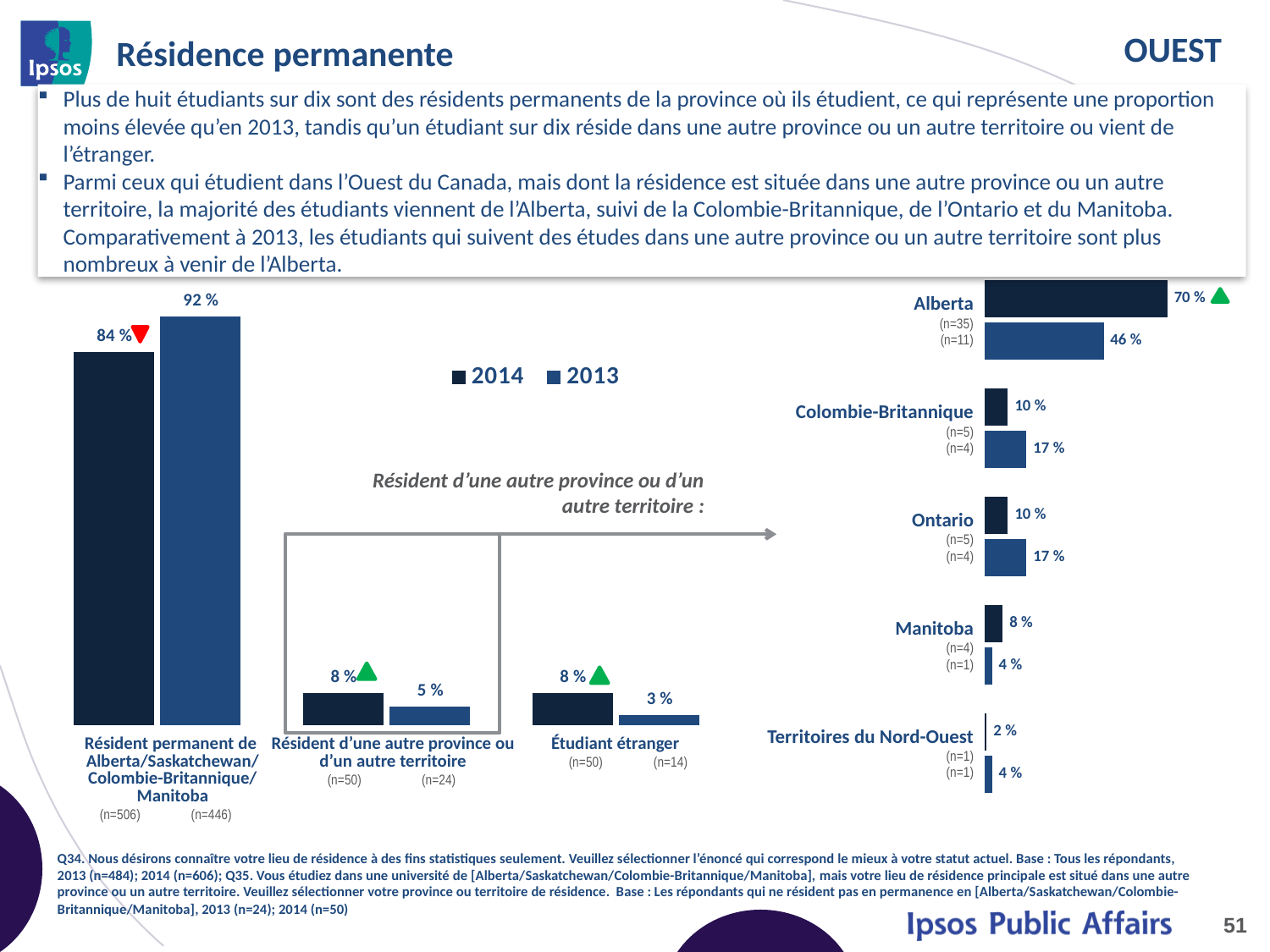
In the left chart, what is the 2013 value for 'Étudiant étranger'? 3 % In the left chart, which is larger for 'Résident d'une autre province ou d'un autre territoire': the 2014 value or the 2013 value? 2014 In the right chart, what is the 2014 value for Alberta? 70 % In the left chart, what is the 2014 value for 'Résident permanent de Alberta/Saskatchewan/Colombie-Britannique/Manitoba'? 84 % In the right chart, which province or territory has the lowest 2014 value? Territoires du Nord-Ouest In the left chart, what is the difference between the 2013 and 2014 values for 'Résident permanent de Alberta/Saskatchewan/Colombie-Britannique/Manitoba'? 8 % In the right chart, which province or territory has the highest 2014 value? Alberta How many series does the legend list? 2 What kind of chart is the right chart? Bar chart In the right chart, what is the 2013 value for Colombie-Britannique? 17 % In the right chart, what is the difference between the 2014 and 2013 values for Alberta? 24 % How many provinces or territories are listed in the right chart? 5